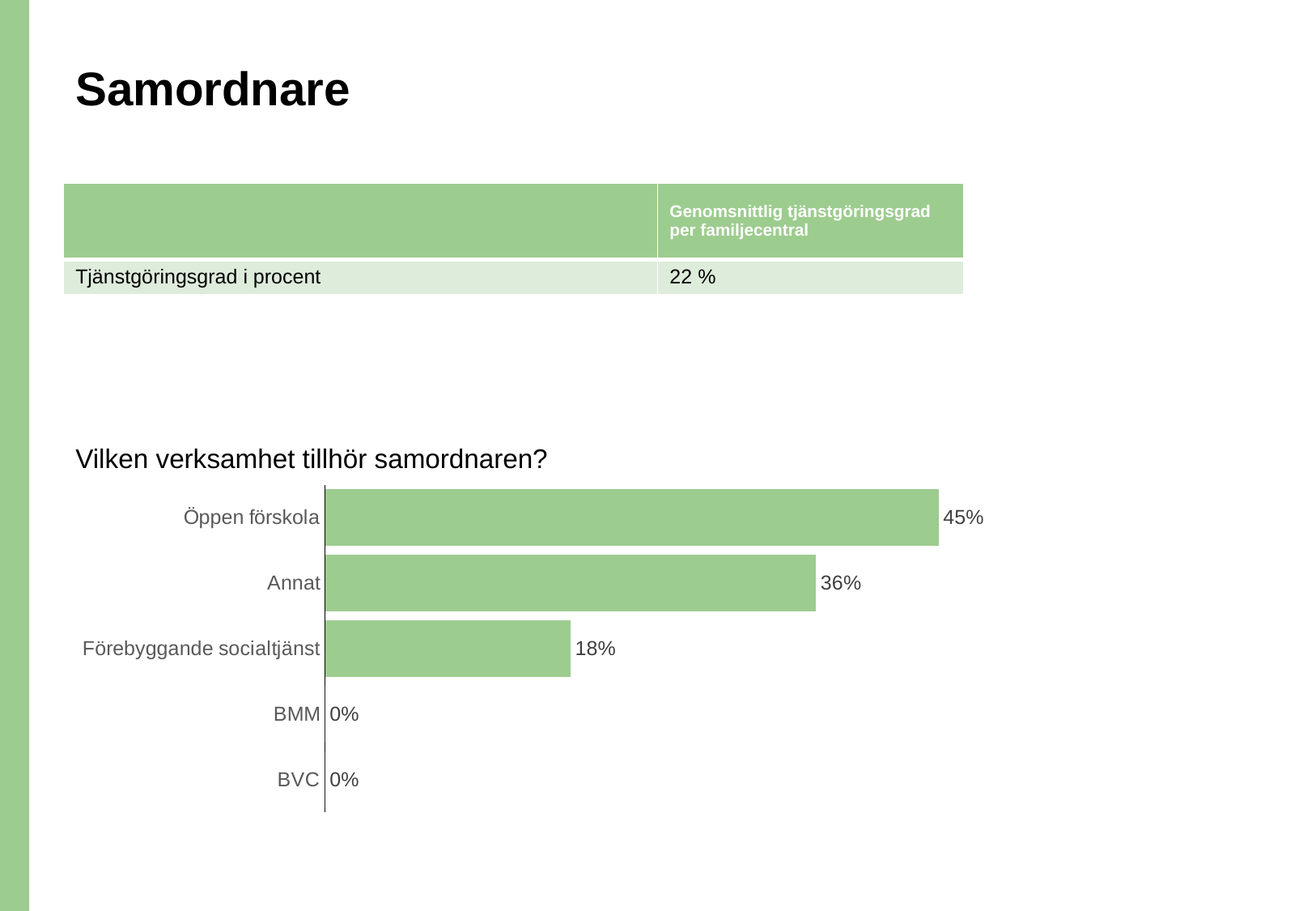
What is the value for Förebyggande socialtjänst in the chart 'Vilken verksamhet tillhör samordnaren?'? 18% Which category has the highest value in the chart 'Vilken verksamhet tillhör samordnaren?'? Öppen förskola What is the value for Annat in the chart 'Vilken verksamhet tillhör samordnaren?'? 36% What is the difference between the values for Öppen förskola and Annat in the chart 'Vilken verksamhet tillhör samordnaren?'? 9% How many categories are shown in the chart 'Vilken verksamhet tillhör samordnaren?'? 5 How many categories in the chart 'Vilken verksamhet tillhör samordnaren?' have a value of 0%? 2 Which is larger in the chart 'Vilken verksamhet tillhör samordnaren?': Annat or Förebyggande socialtjänst? Annat What is the value for BMM in the chart 'Vilken verksamhet tillhör samordnaren?'? 0% What is the title of the chart on the slide? Vilken verksamhet tillhör samordnaren? What is the difference between the values for Annat and Förebyggande socialtjänst in the chart 'Vilken verksamhet tillhör samordnaren?'? 18% What kind of chart is 'Vilken verksamhet tillhör samordnaren?'? Bar chart What is the value for Öppen förskola in the chart 'Vilken verksamhet tillhör samordnaren?'? 45%